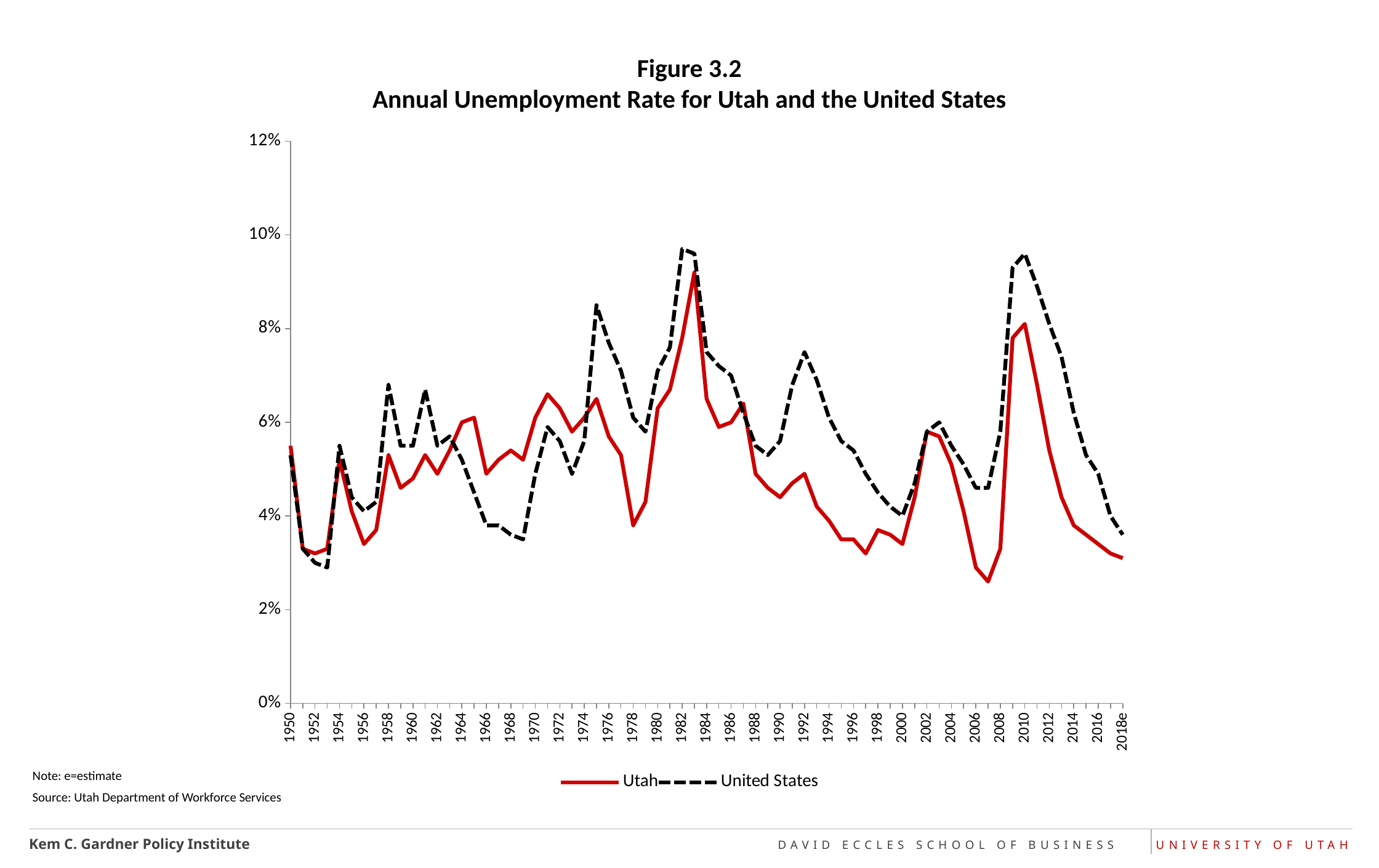
What kind of chart is shown on the slide? Line chart In 2010, which series has the higher unemployment rate, Utah or the United States? United States What is the title of the chart? Figure 3.2 Annual Unemployment Rate for Utah and the United States Is the United States unemployment rate in 1992 greater or less than 6%? greater Is the Utah unemployment rate in 1983 greater or less than 8%? greater Which series is drawn with a dashed line? United States Does the Utah unemployment rate rise or fall from 2010 to 2018e? Fall Is the Utah unemployment rate in 2007 greater or less than 4%? less In 1969, which series has the higher unemployment rate, Utah or the United States? Utah In which year does the Utah series reach its highest value? 1983 How many series does the legend list? 2